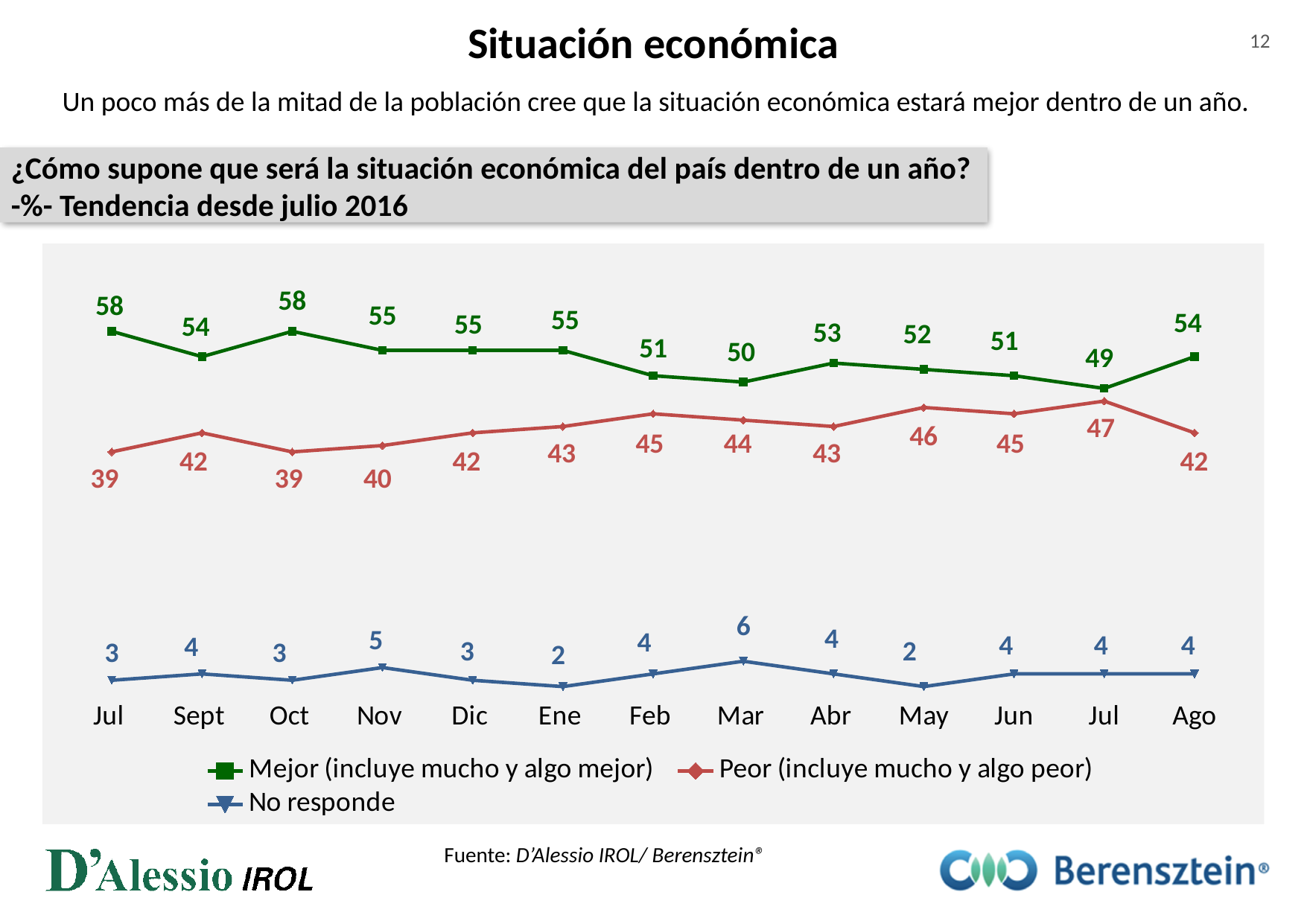
Between Ene and Mar, does the 'Mejor' series rise or fall? fall What is the value of 'Peor (incluye mucho y algo peor)' in Nov? 40 What is the value of 'No responde' in Mar? 6 In Feb, what is the difference between the 'Mejor' value and the 'Peor' value? 6 Which series is drawn with the green line? Mejor (incluye mucho y algo mejor) Which month has the higher 'Mejor' value, Sept or Oct? Oct How many months are plotted along the x axis? 13 What is the highest value reached by the 'Peor' series? 47 How many series does the legend list? 3 What type of chart is shown on the slide? line chart What is the lowest value reached by the 'Mejor' series? 49 What is the value of 'Mejor (incluye mucho y algo mejor)' in Ago? 54